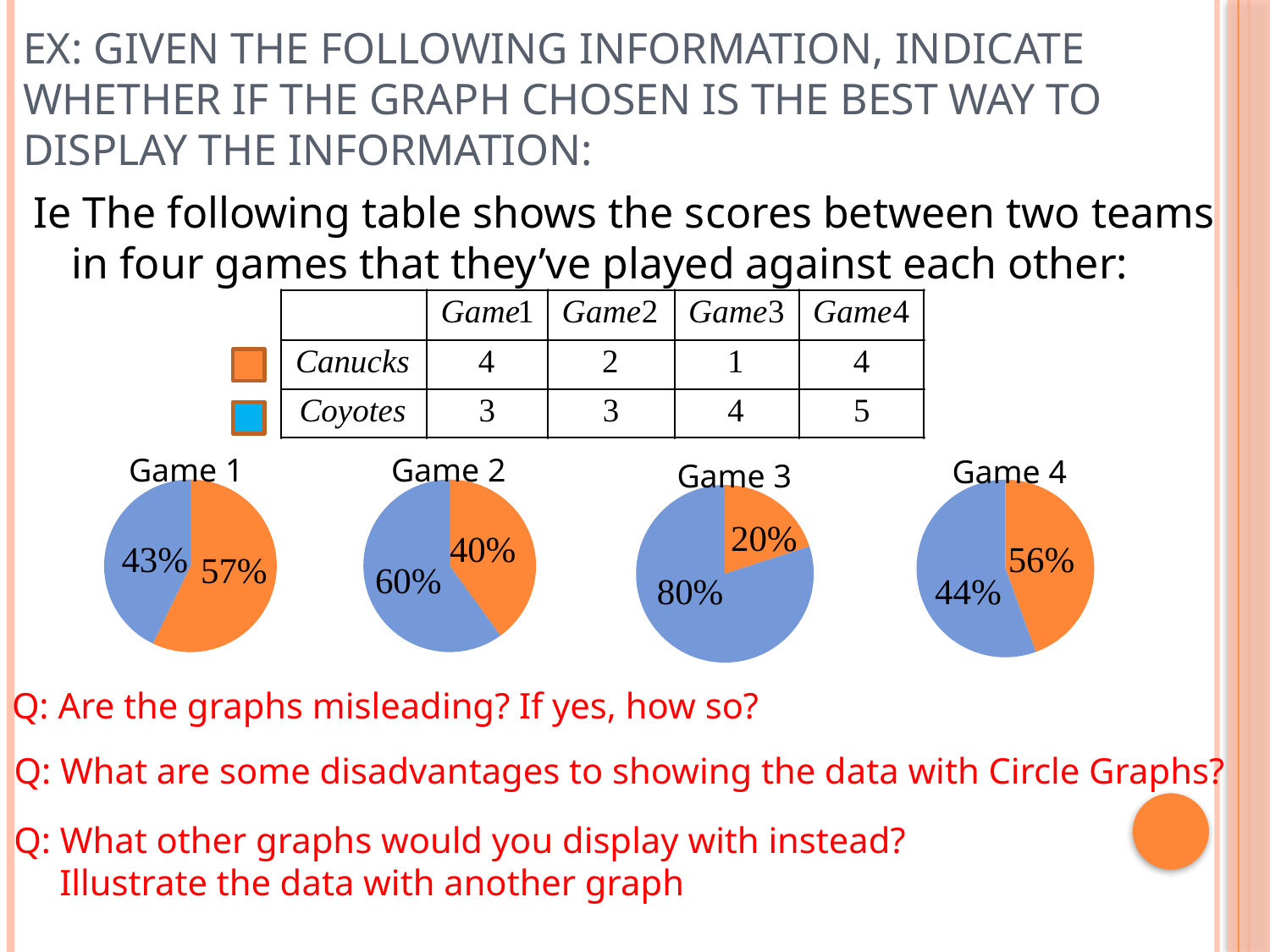
In the Game 3 pie chart, what share does the orange slice (Canucks) have? 20% How many slices does each pie chart have? 2 In the Game 1 pie chart, what share does the orange slice (Canucks) have? 57% In the Game 2 pie chart, what share does the blue slice (Coyotes) have? 60% What kind of chart is used for Game 1? Pie chart In the Game 3 pie chart, what is the difference between the blue slice's share and the orange slice's share? 60% Across the four pie charts, which game has the largest orange (Canucks) slice? Game 1 In the Game 3 pie chart, which slice is larger, the orange one or the blue one? Blue How many pie charts are shown on the slide? 4 Across the four pie charts, which game has the smallest orange (Canucks) slice? Game 3